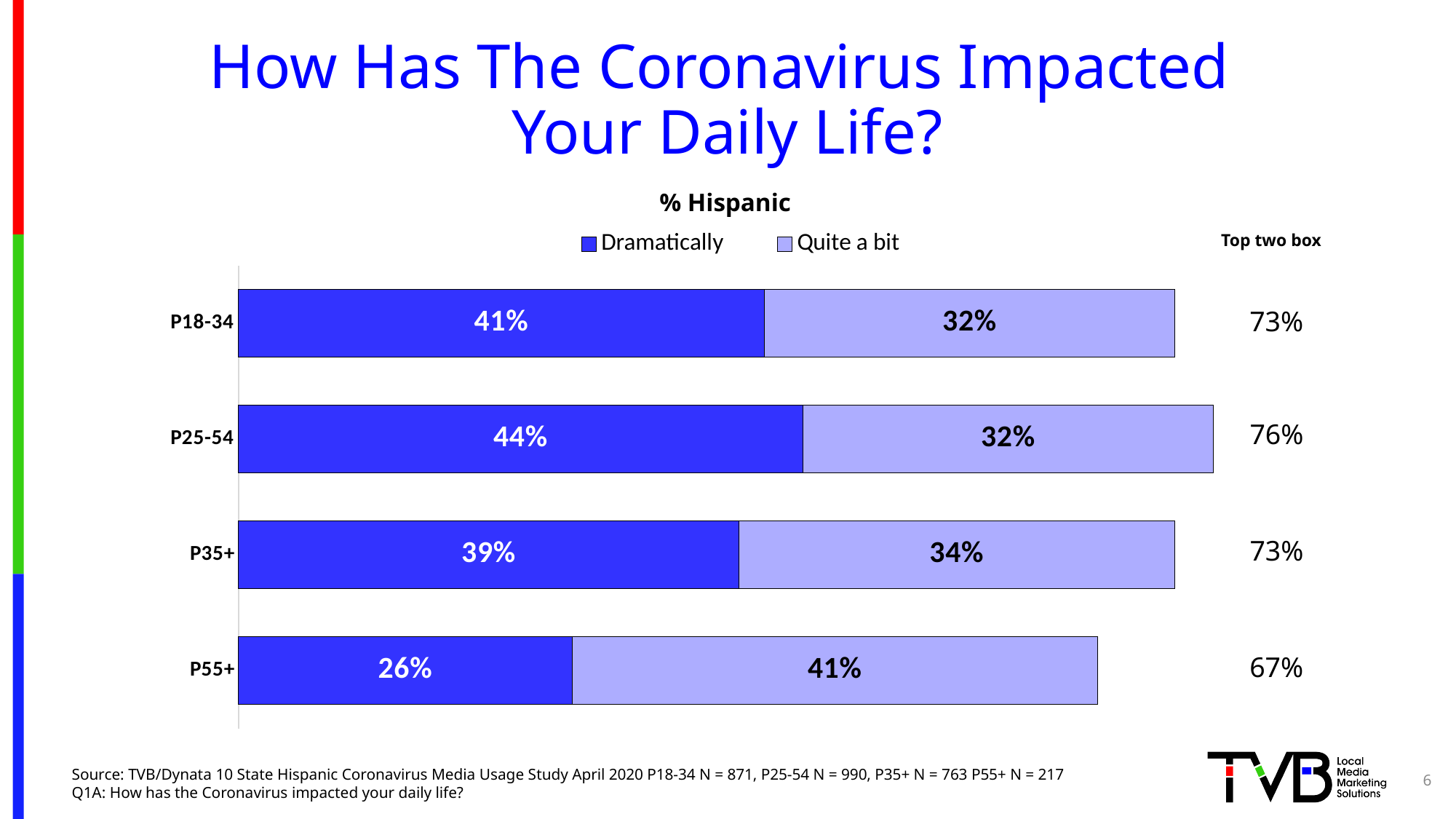
What is the "Quite a bit" value for P55+? 41% What is the total of the stacked bar for P35+ (Dramatically plus Quite a bit)? 73% Which is larger for P55+: the "Dramatically" value or the "Quite a bit" value? Quite a bit Which age group has the highest "Dramatically" value? P25-54 What is the Top two box value shown for P25-54? 76% How many age groups are shown in the chart? 4 What is the "Dramatically" value for P35+? 39% What percentage of P18-34 said the coronavirus impacted their daily life "Dramatically"? 41% Which age group has the lowest "Dramatically" value? P55+ How many series does the legend list? 2 What kind of chart is shown on the slide? Stacked bar chart What is the difference between the "Dramatically" values for P25-54 and P55+? 18 percentage points